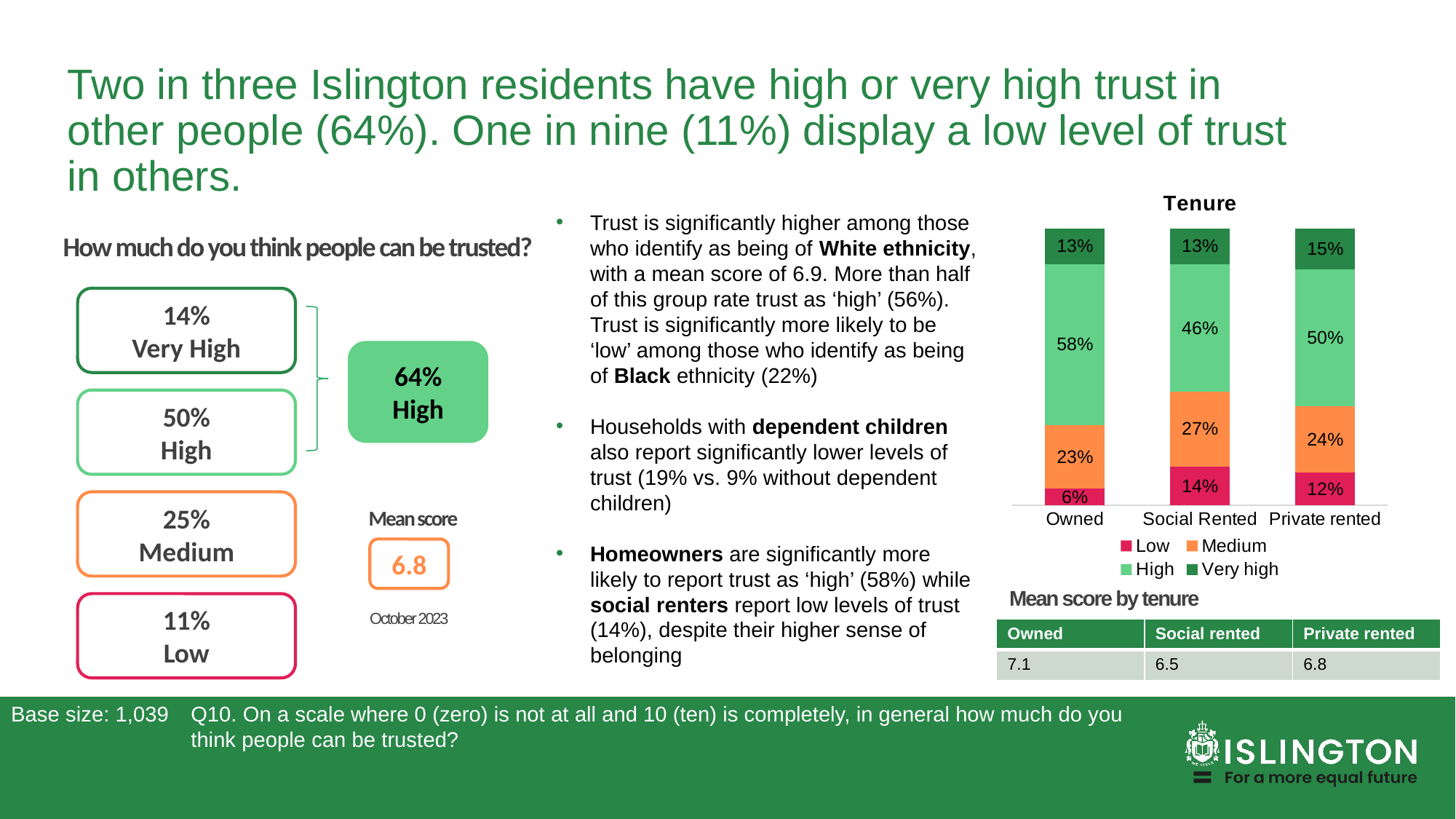
In the Tenure chart, what is the Very high value for Private rented? 15% In the Tenure chart, is the Medium value larger for Social Rented or for Owned? Social Rented In the Tenure chart, what is the total of the Social Rented bar? 100% How many tenure categories are shown on the x axis of the Tenure chart? 3 How many series does the legend of the Tenure chart list? 4 In the Tenure chart, what is the Low value for Social Rented? 14% In the Tenure chart, which tenure group has the lowest Low value? Owned In the Tenure chart, what percentage of Owned residents report High trust? 58% In the Tenure chart, which tenure group has the highest High value? Owned In the Tenure chart, what is the difference between the High values for Owned and Social Rented? 12 percentage points What kind of chart is the Tenure chart? Stacked bar chart In the Tenure chart, what is the Medium value for Private rented? 24%